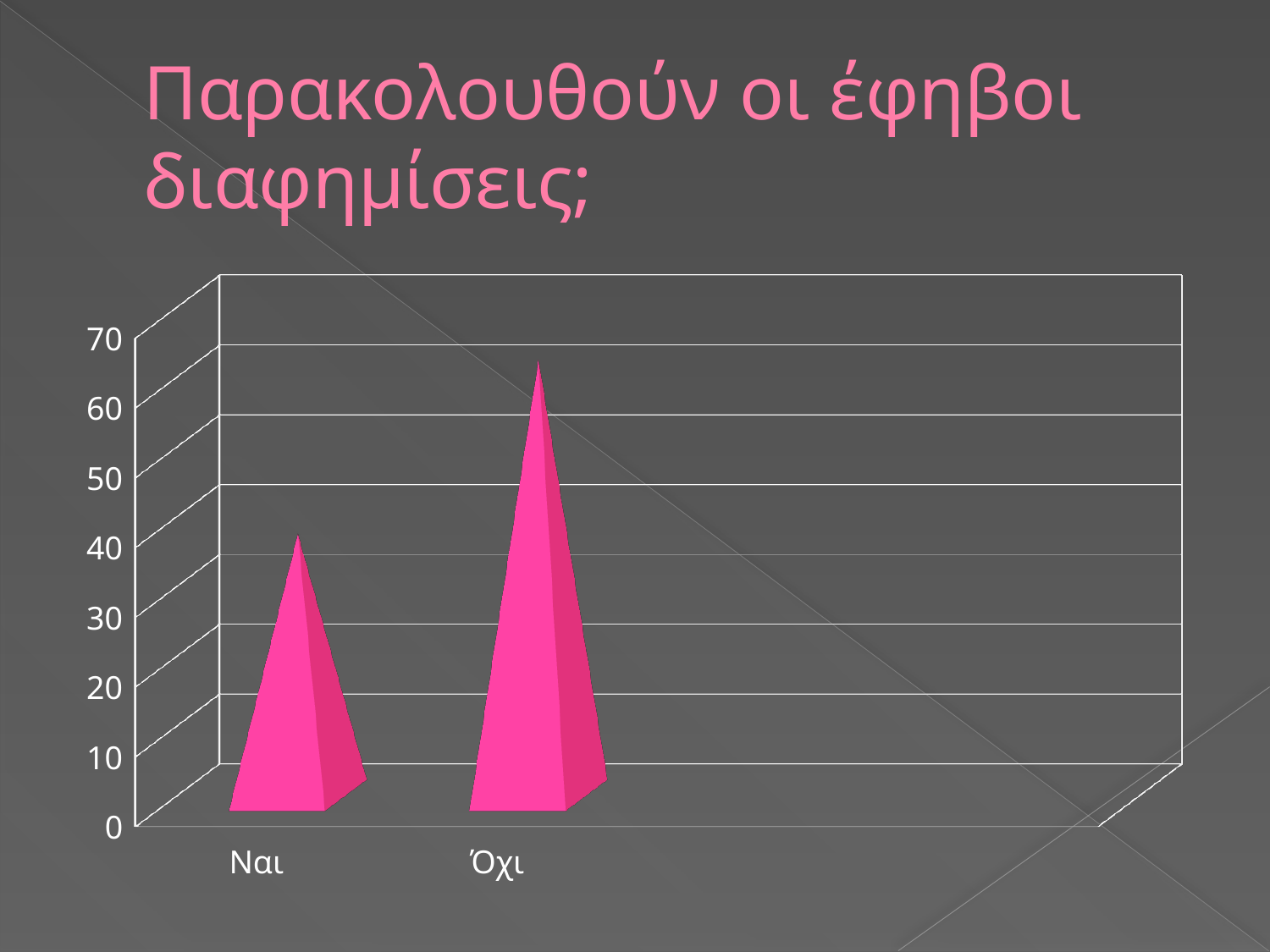
Which is larger, the value for Ναι or the value for Όχι? Όχι Which category has the lowest value in the chart? Ναι Is the value for Ναι greater or less than 50? less Which category has the highest value in the chart? Όχι What kind of chart is shown on the slide? bar chart Is the value for Όχι greater or less than 50? greater Is the value for Ναι greater or less than 30? greater Do the values rise or fall from Ναι to Όχι along the x axis? rise What is the title of the slide containing the chart? Παρακολουθούν οι έφηβοι διαφημίσεις; What colour are the bars in the chart? pink How many categories are shown on the x axis of the chart? 2